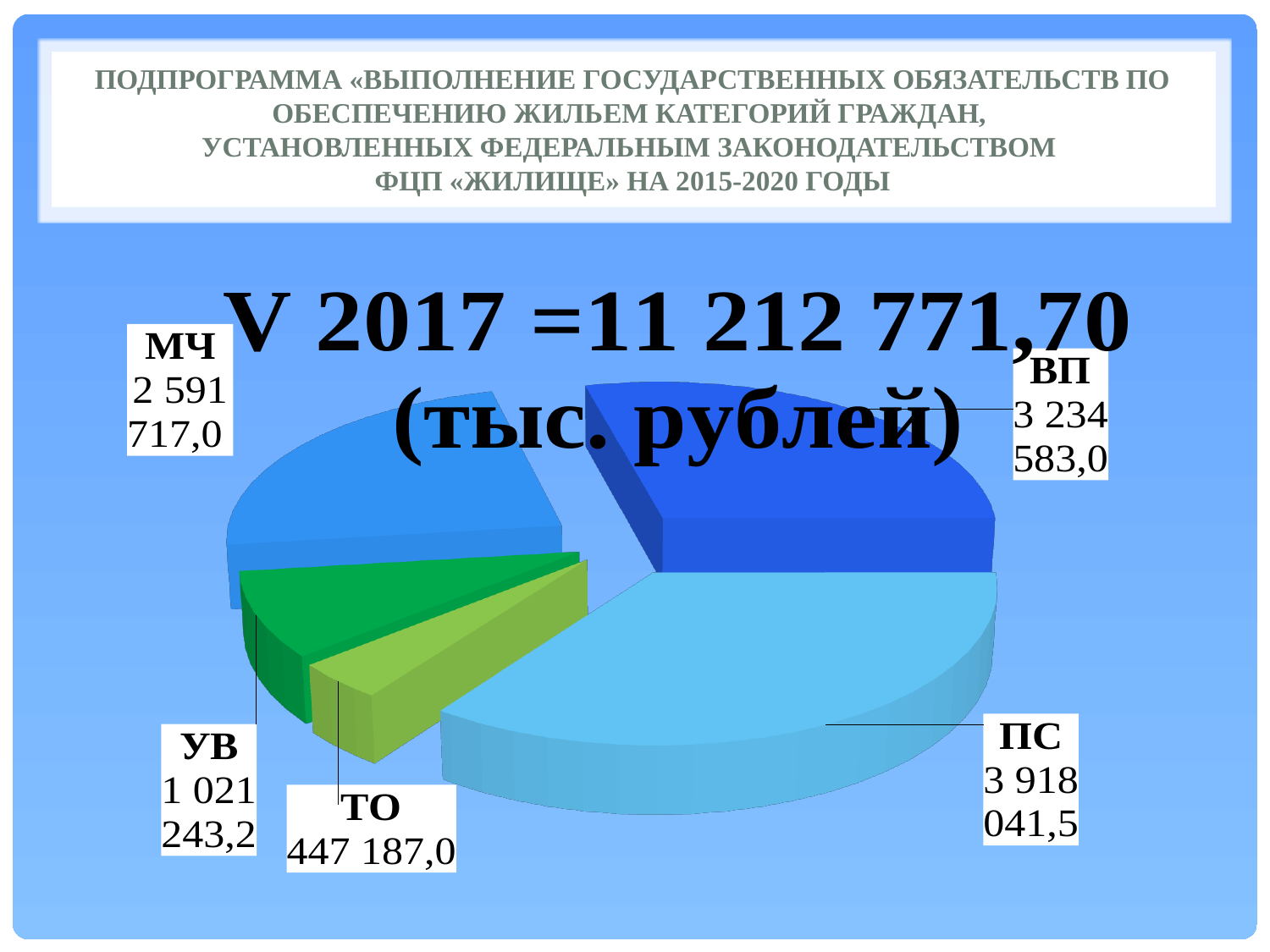
What is the value for МЧ on the pie chart? 2 591 717,0 Which is larger, the value for ВП or the value for МЧ? ВП How many categories are shown on the pie chart? 5 What total value for 2017 is stated on the slide above the chart? 11 212 771,70 (тыс. рублей) What is the value for ПС on the pie chart? 3 918 041,5 What is the difference between the values for УВ and ТО? 574 056,2 What is the value for ВП on the pie chart? 3 234 583,0 Which category has the largest slice of the pie chart? ПС What kind of chart is shown on the slide? Pie chart What is the difference between the values for ПС and ВП? 683 458,5 What is the value for ТО on the pie chart? 447 187,0 Which category has the smallest slice of the pie chart? ТО